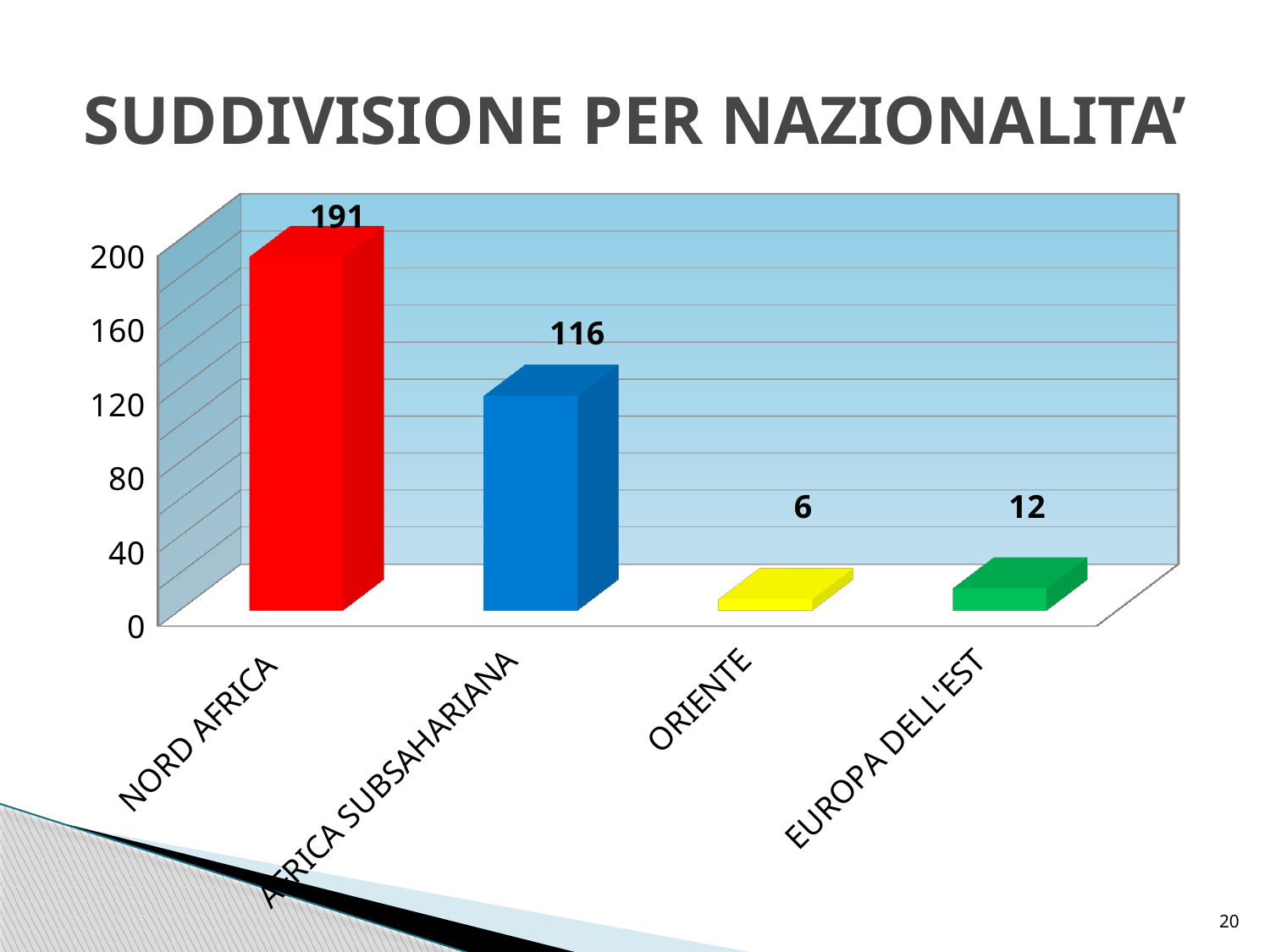
What is the difference between the values for NORD AFRICA and AFRICA SUBSAHARIANA? 75 Which category has the lowest value? ORIENTE What is the title of the slide? SUDDIVISIONE PER NAZIONALITA' What is the value for AFRICA SUBSAHARIANA? 116 Is the value for AFRICA SUBSAHARIANA greater or less than 80? greater What is the value for EUROPA DELL'EST? 12 Which category has the highest value? NORD AFRICA What is the value for NORD AFRICA? 191 What is the value for ORIENTE? 6 How many categories are shown on the chart? 4 What kind of chart is shown on the slide? bar chart Which is larger, the value for EUROPA DELL'EST or the value for ORIENTE? EUROPA DELL'EST